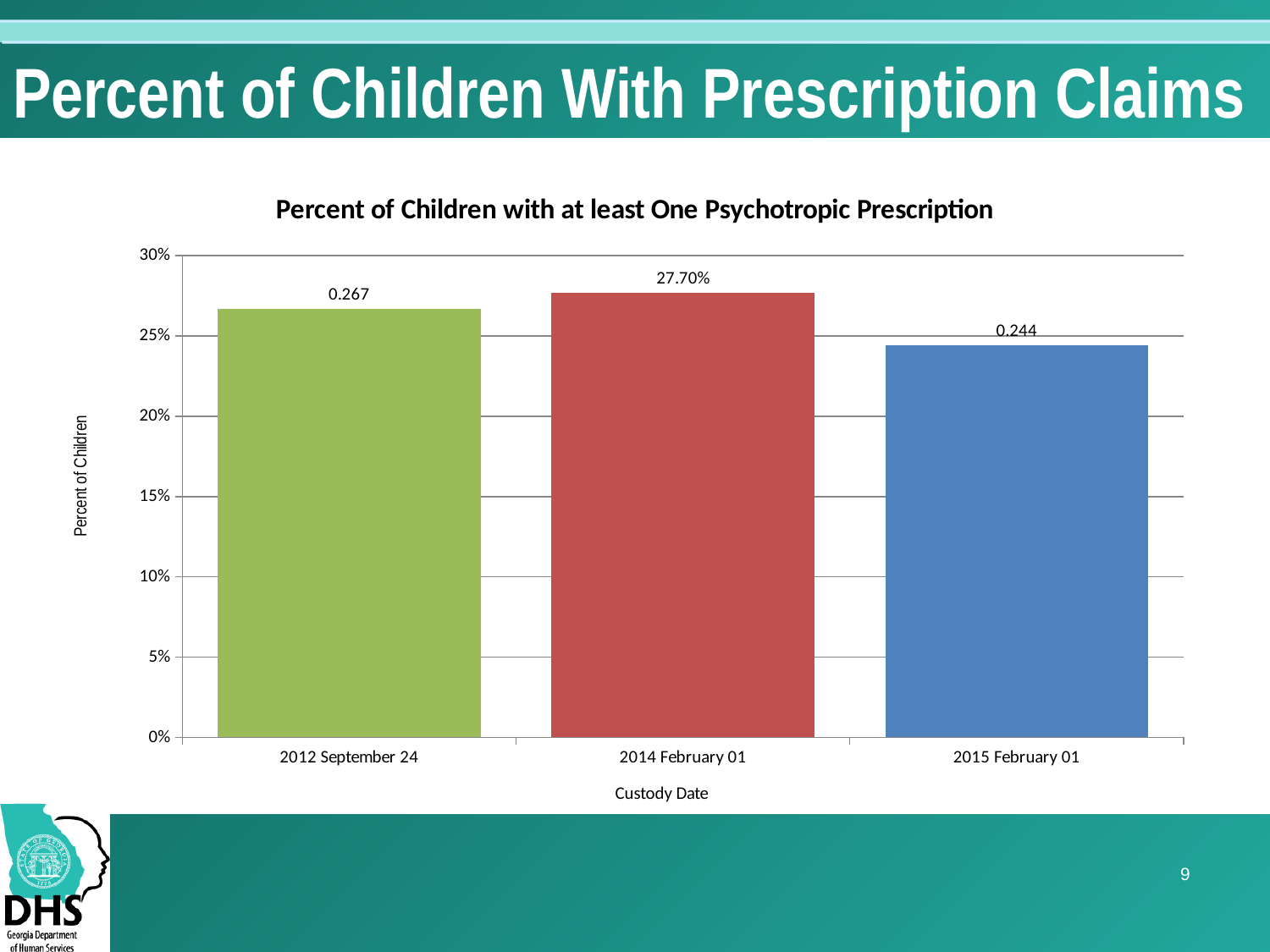
Which custody date has the highest percent of children with at least one psychotropic prescription? 2014 February 01 What is the data label shown on the bar for 2014 February 01? 27.70% What is the data label shown on the bar for 2012 September 24? 0.267 How many custody dates are shown on the x axis? 3 Which bar is taller, 2012 September 24 or 2015 February 01? 2012 September 24 What is the difference between the data labels for 2012 September 24 and 2015 February 01? 0.023 What is the data label shown on the bar for 2015 February 01? 0.244 What kind of chart is shown on the slide? Bar chart Which custody date has the lowest percent of children with at least one psychotropic prescription? 2015 February 01 What is the label of the x axis? Custody Date Is the value for 2015 February 01 greater or less than 25%? less Is the value for 2012 September 24 greater or less than 25%? greater